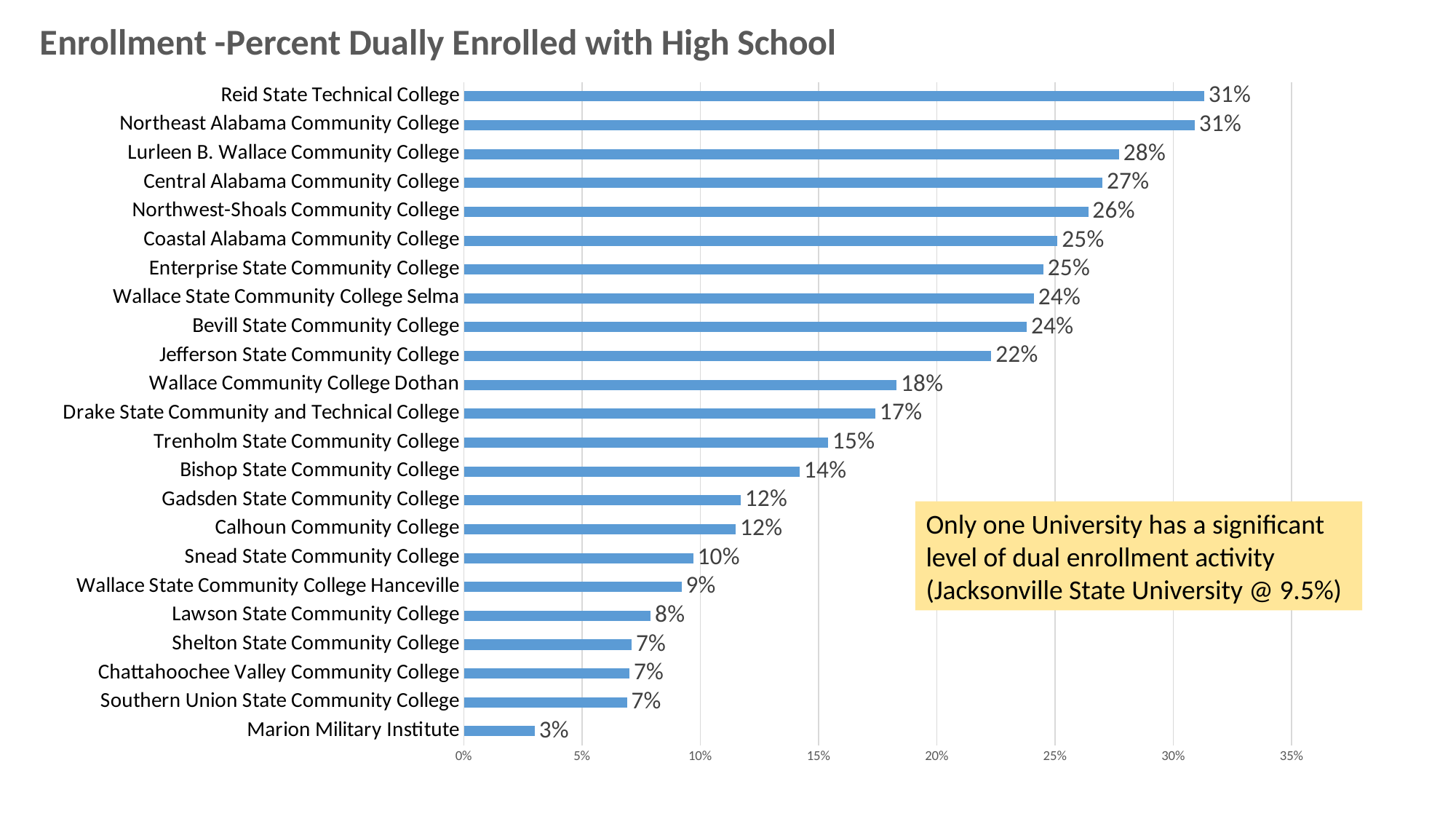
What is the value for Lurleen B. Wallace Community College? 28% According to the callout box, which university has a significant level of dual enrollment activity? Jacksonville State University What is the value for Wallace State Community College Hanceville? 9% What is the value for Jefferson State Community College? 22% How many colleges are shown in the chart? 23 What kind of chart is shown on the slide? bar chart Which is larger, the value for Trenholm State Community College or the value for Snead State Community College? Trenholm State Community College What is the difference between the values for Central Alabama Community College and Bishop State Community College? 13% What is the title of the chart? Enrollment -Percent Dually Enrolled with High School Is the value for Wallace Community College Dothan greater or less than 20%? less What is the value for Marion Military Institute? 3% Which college has the lowest percent dually enrolled with high school? Marion Military Institute